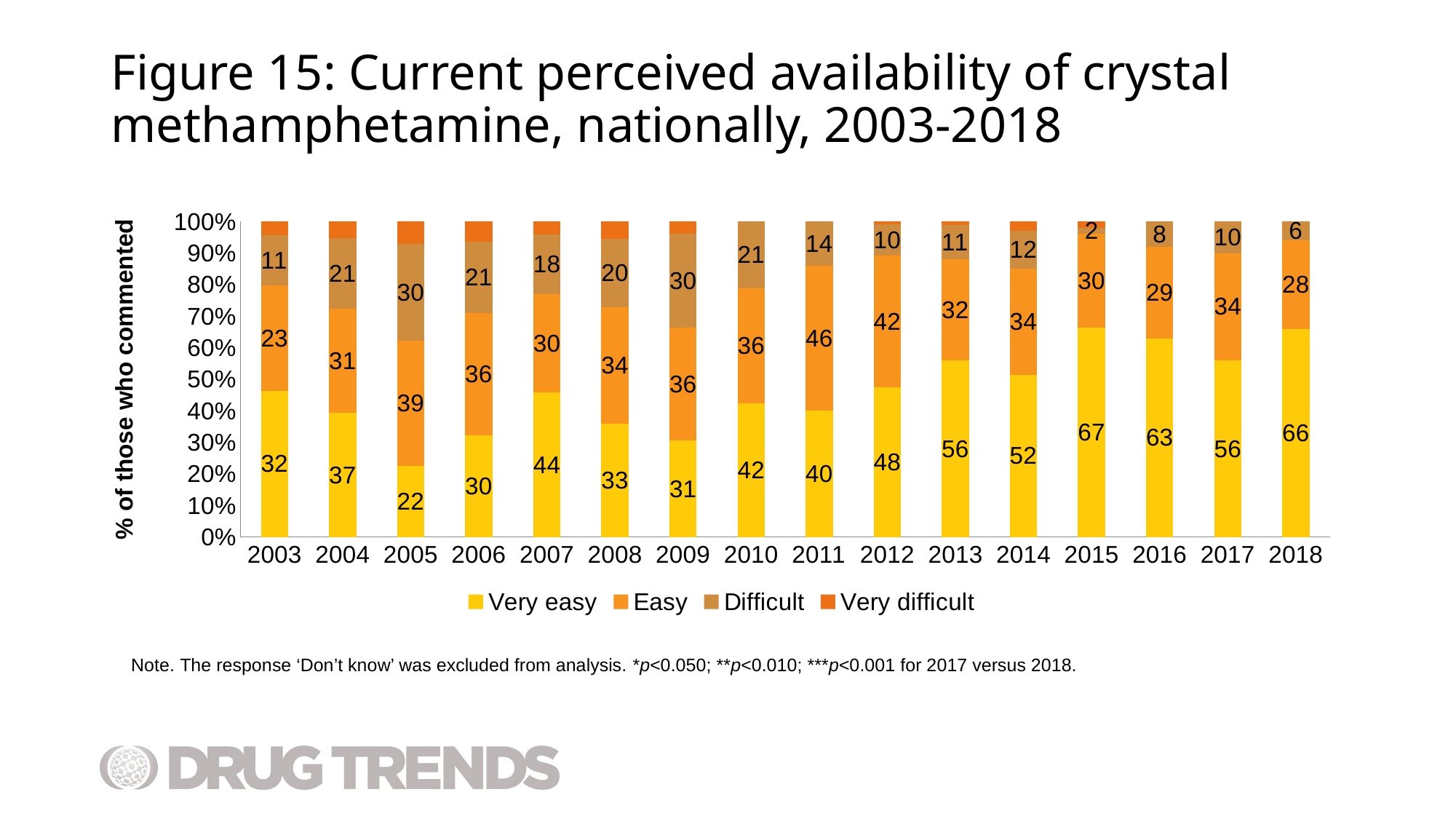
In which year was the 'Very easy' share highest? 2015 How many years are shown on the x axis? 16 What is the label of the y axis? % of those who commented Which is larger, the 'Easy' value for 2012 or the 'Easy' value for 2013? 2012 Did the 'Difficult' share generally rise or fall between 2009 and 2018? Fall In which year was the 'Very easy' share lowest? 2005 What is the difference between the 'Very easy' values for 2018 and 2017? 10 What is the 'Easy' value for 2011? 46 What percentage of respondents rated crystal methamphetamine as 'Very easy' to obtain in 2018? 66 What kind of chart is shown on the slide? Stacked bar chart What is the 'Difficult' value for 2005? 30 How many series does the legend list? 4